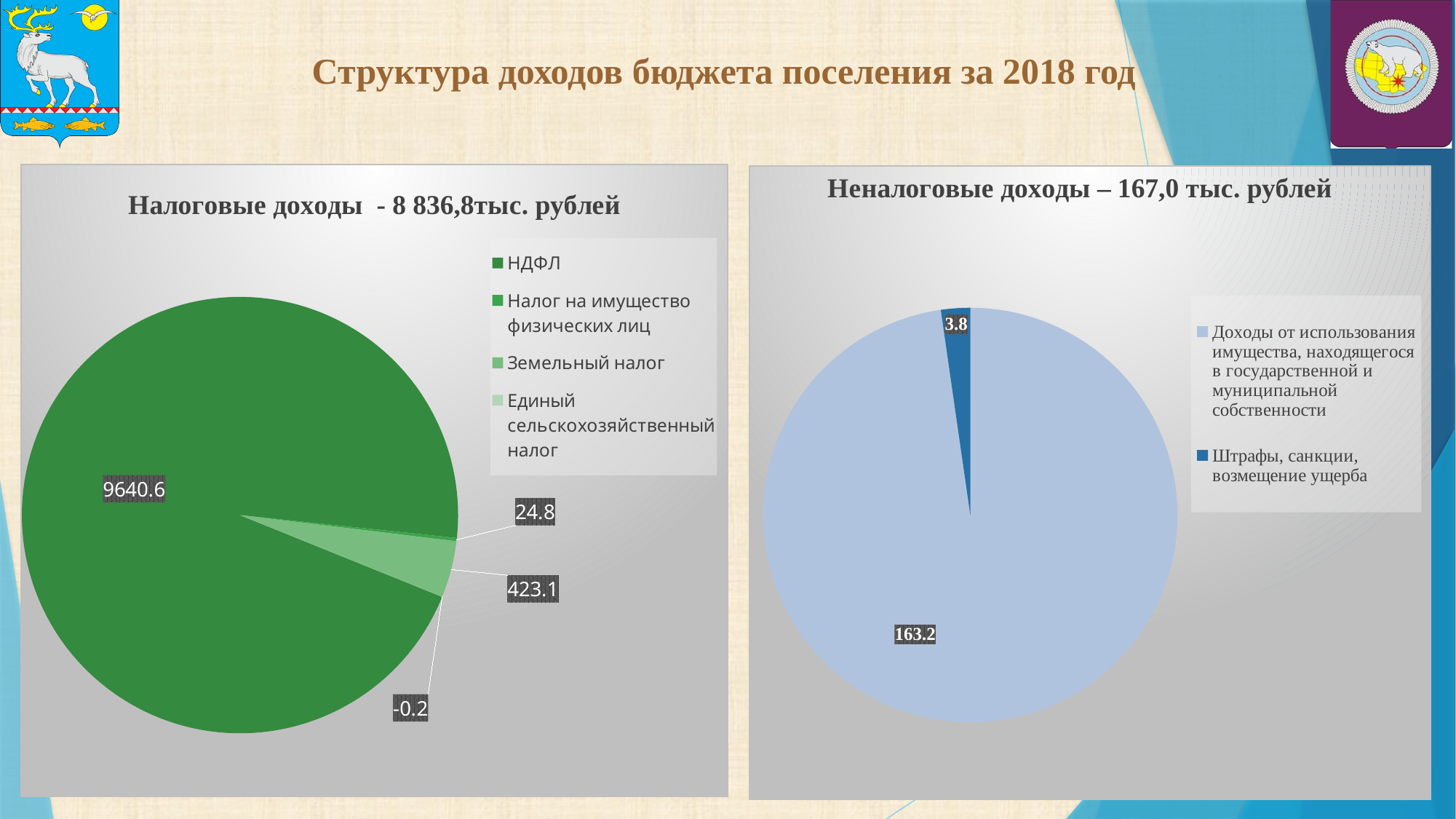
In the right chart (Неналоговые доходы), what is the difference between the value for Доходы от использования имущества and the value for Штрафы, санкции, возмещение ущерба? 159.4 What total amount is stated in the title of the right chart (Неналоговые доходы)? 167,0 тыс. рублей In the left chart (Налоговые доходы), what is the smallest data label value shown? -0.2 In the right chart (Неналоговые доходы), what value is shown for Доходы от использования имущества, находящегося в государственной и муниципальной собственности? 163.2 In the left chart (Налоговые доходы), what value is shown for НДФЛ? 9640.6 In the left chart (Налоговые доходы), how many entries does the legend list? 4 In the right chart (Неналоговые доходы), what value is shown for Штрафы, санкции, возмещение ущерба? 3.8 In the left chart (Налоговые доходы), which category has the largest slice? НДФЛ In the right chart (Неналоговые доходы), how many slices does the pie have? 2 In the right chart (Неналоговые доходы), which is larger: Доходы от использования имущества or Штрафы, санкции, возмещение ущерба? Доходы от использования имущества In the left chart (Налоговые доходы), how many slices are labelled with values? 4 What kind of chart is the left chart titled "Налоговые доходы - 8 836,8тыс. рублей"? pie chart